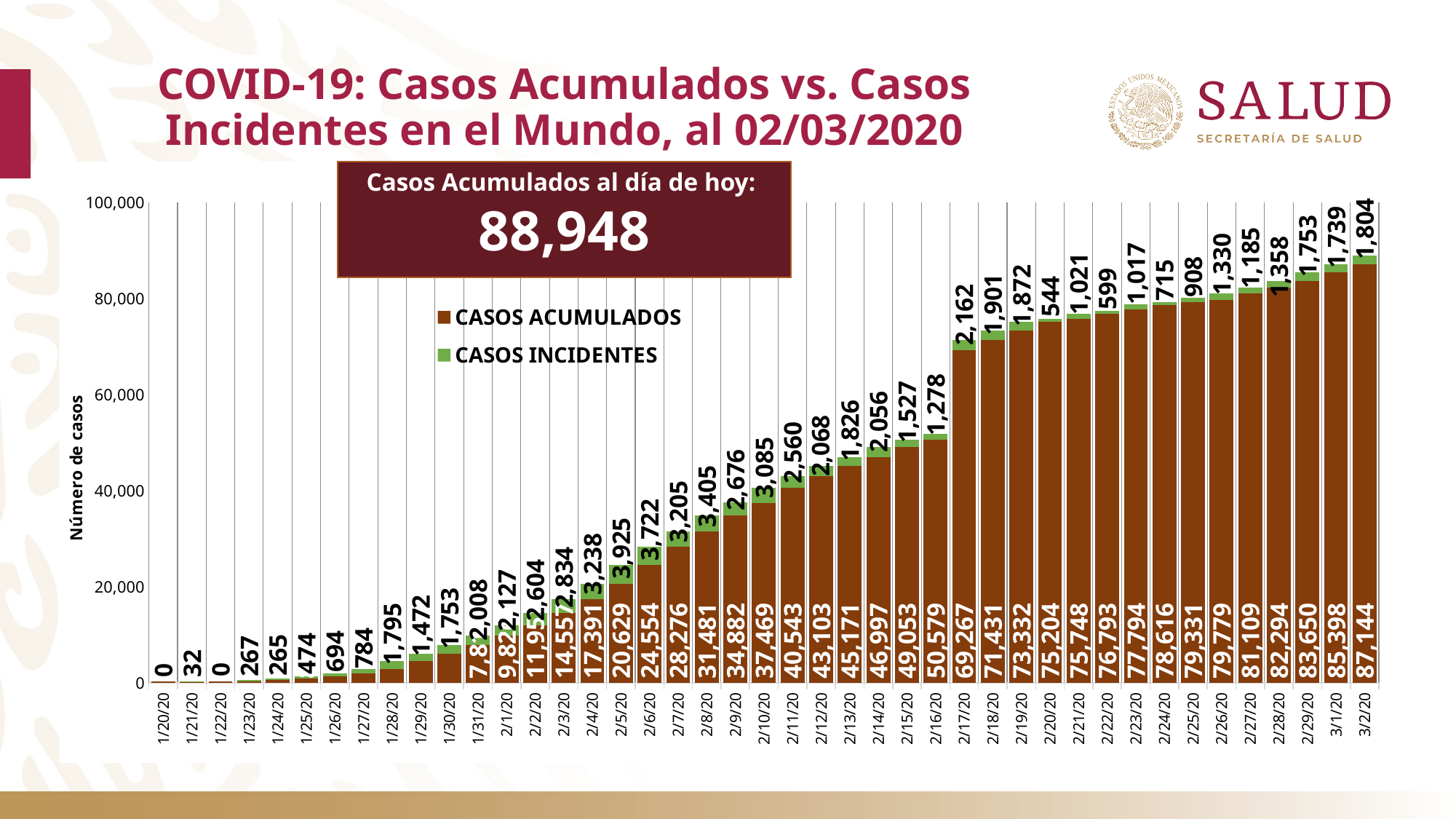
How many series does the legend list? 2 What is the CASOS INCIDENTES value for 2/5/20? 3,925 What is the CASOS ACUMULADOS value for 3/2/20? 87,144 What kind of chart is shown on the slide? Stacked bar chart Which date has the highest CASOS INCIDENTES value? 2/5/20 Which date has the larger CASOS INCIDENTES value, 2/18/20 or 2/19/20? 2/18/20 Do the CASOS ACUMULADOS values rise or fall from 1/31/20 to 3/2/20? Rise What is the total of the stacked bar for 3/2/20 (CASOS ACUMULADOS plus CASOS INCIDENTES)? 88,948 What is the CASOS ACUMULADOS value for 2/17/20? 69,267 Is the CASOS ACUMULADOS value for 2/16/20 greater or less than 60,000? less What is the difference between the CASOS ACUMULADOS values for 3/2/20 and 3/1/20? 1,746 Which date has the lowest CASOS INCIDENTES value among the dates from 2/17/20 to 3/2/20? 2/20/20